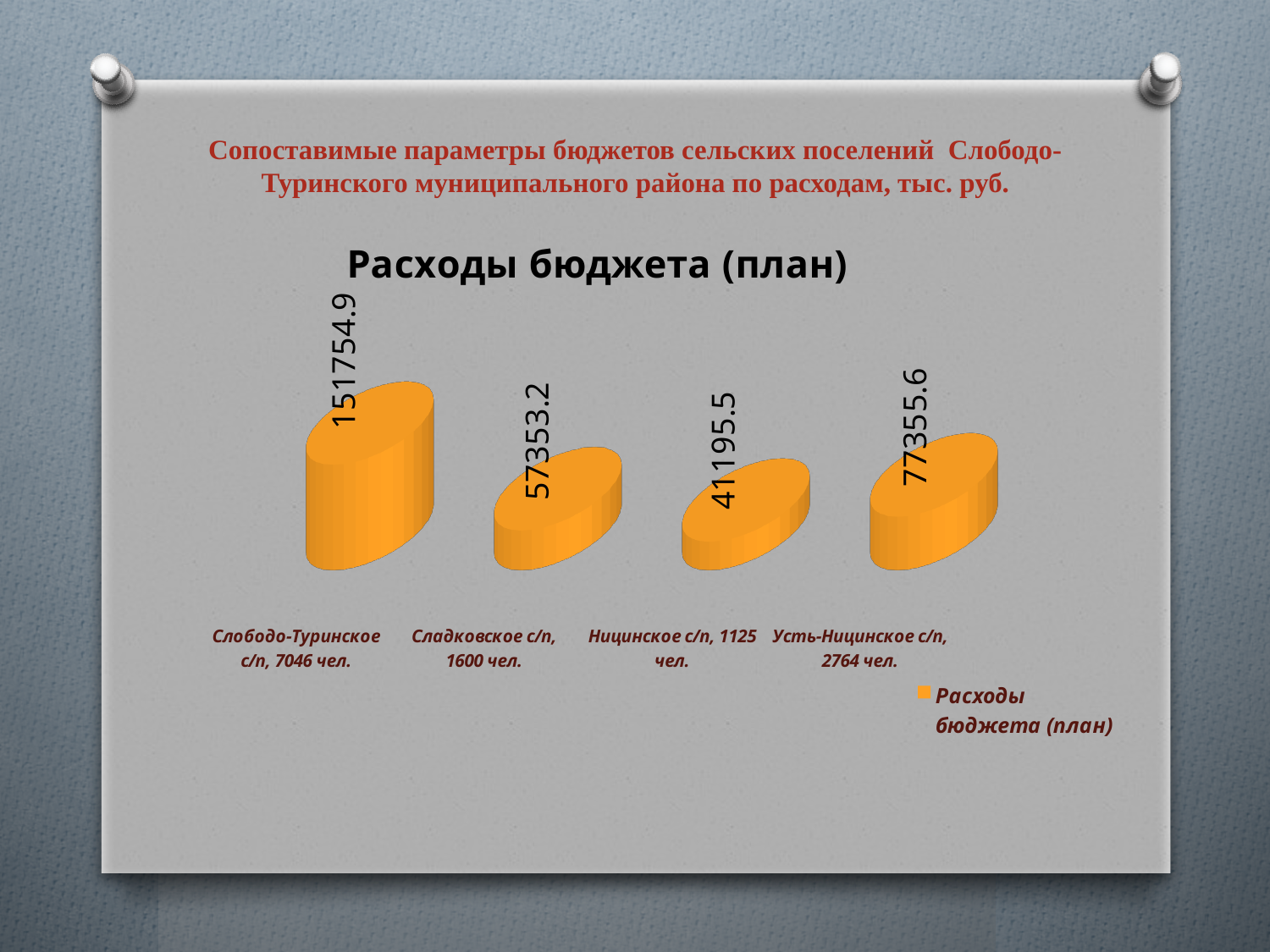
What is the difference between the planned expenditure of Слободо-Туринское с/п and Сладковское с/п? 94401.7 Which settlement has the lowest planned budget expenditure? Ницинское с/п What is the title of the chart? Расходы бюджета (план) How many settlements are shown in the chart? 4 Which has a larger planned budget expenditure, Сладковское с/п or Усть-Ницинское с/п? Усть-Ницинское с/п What is the planned budget expenditure value for Усть-Ницинское с/п? 77355.6 Which settlement has the highest planned budget expenditure? Слободо-Туринское с/п What is the planned budget expenditure value for Ницинское с/п? 41195.5 What is the planned budget expenditure value for Слободо-Туринское с/п? 151754.9 What type of chart is shown on the slide? Bar chart What is the planned budget expenditure value for Сладковское с/п? 57353.2 What is the difference between the planned expenditure of Усть-Ницинское с/п and Ницинское с/п? 36160.1